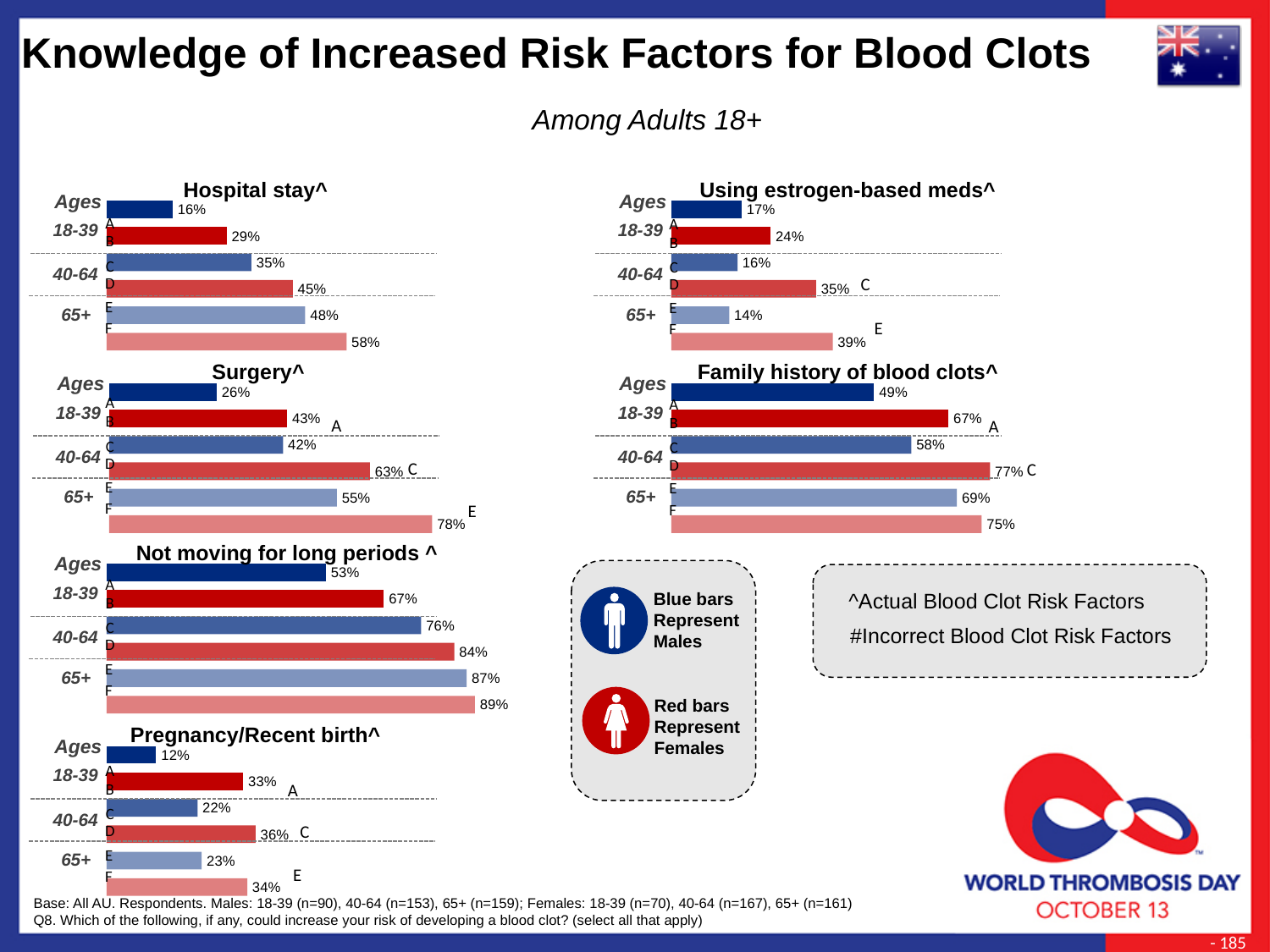
In the 'Family history of blood clots' chart, what is the difference between females aged 40-64 and males aged 40-64? 19 percentage points In the 'Pregnancy/Recent birth' chart, which bar has the lowest value? Males 18-39 (12%) In the 'Surgery' chart, what is the value for males aged 18-39? 26% What type of chart is used to show the 'Hospital stay' data? Bar chart In the 'Hospital stay' chart, what is the value for females aged 65+? 58% How many separate bar charts are shown on the slide? 6 In the 'Surgery' chart, what is the difference between females aged 65+ and males aged 65+? 23 percentage points According to the legend on the slide, what do the blue bars represent? Males In the 'Using estrogen-based meds' chart, which is larger: the value for females aged 65+ or females aged 18-39? Females aged 65+ (39%) In the 'Using estrogen-based meds' chart, what is the value for males aged 65+? 14% In the 'Not moving for long periods' chart, which age group and gender has the highest value? Females 65+ (89%) In the 'Hospital stay' chart, do the male values rise or fall as the age group increases from 18-39 to 65+? Rise